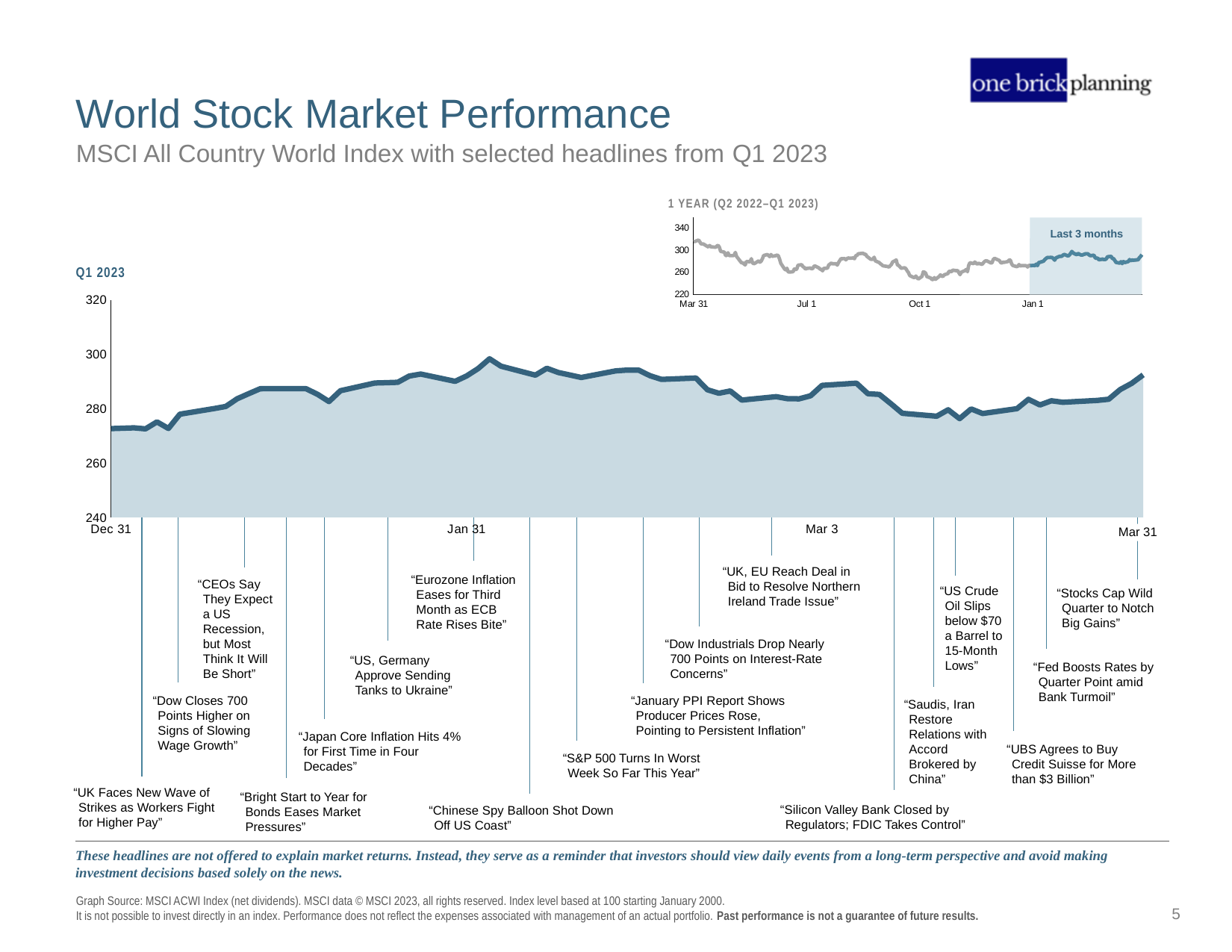
On the 1 YEAR (Q2 2022–Q1 2023) inset chart, which is higher: the index value at Mar 31 (the start) or at Jan 1? Mar 31 On the Q1 2023 chart, how many date labels are shown on the x axis? 4 On the Q1 2023 chart, what kind of chart is used to show the index level? area chart On the Q1 2023 chart, which is higher: the index value at Dec 31 or at Mar 31? Mar 31 On the 1 YEAR (Q2 2022–Q1 2023) inset chart, what kind of chart is shown? line chart On the Q1 2023 chart, is the index value at Dec 31 greater or less than 280? less On the 1 YEAR (Q2 2022–Q1 2023) inset chart, is the index value at Mar 31 (the start) greater or less than 300? greater What label is shown on the shaded region of the 1 YEAR (Q2 2022–Q1 2023) inset chart? Last 3 months On the Q1 2023 chart, does the index ever fall below 260 during the quarter? No On the 1 YEAR (Q2 2022–Q1 2023) inset chart, does the index generally rise or fall between Mar 31 and Oct 1? fall